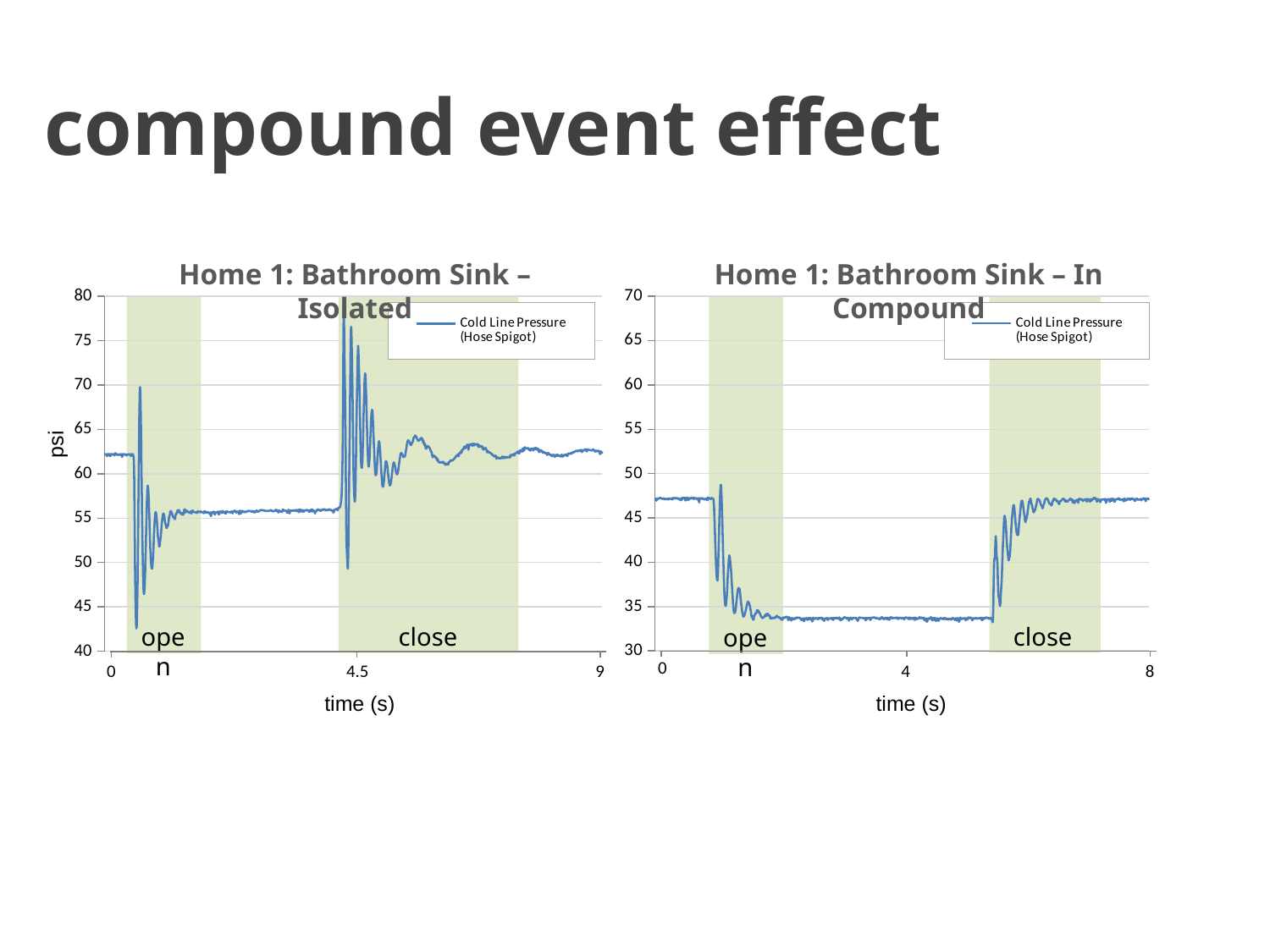
In the 'Home 1: Bathroom Sink – Isolated' chart, is the pressure at time 3 s greater or less than 60? less In the 'Home 1: Bathroom Sink – In Compound' chart, how many series does the legend list? 1 What kind of chart is the 'Home 1: Bathroom Sink – In Compound' chart? line chart In the 'Home 1: Bathroom Sink – Isolated' chart, is the highest peak of the line greater or less than 75? greater In the 'Home 1: Bathroom Sink – Isolated' chart, what is the label on the vertical axis? psi In the 'Home 1: Bathroom Sink – In Compound' chart, is the pressure at time 4 s greater or less than 40? less What kind of chart is the 'Home 1: Bathroom Sink – Isolated' chart? line chart In the 'Home 1: Bathroom Sink – Isolated' chart, how many series does the legend list? 1 In the 'Home 1: Bathroom Sink – Isolated' chart, what series name does the legend show? Cold Line Pressure (Hose Spigot) In the 'Home 1: Bathroom Sink – In Compound' chart, does the pressure rise or fall after the 'close' event? rise